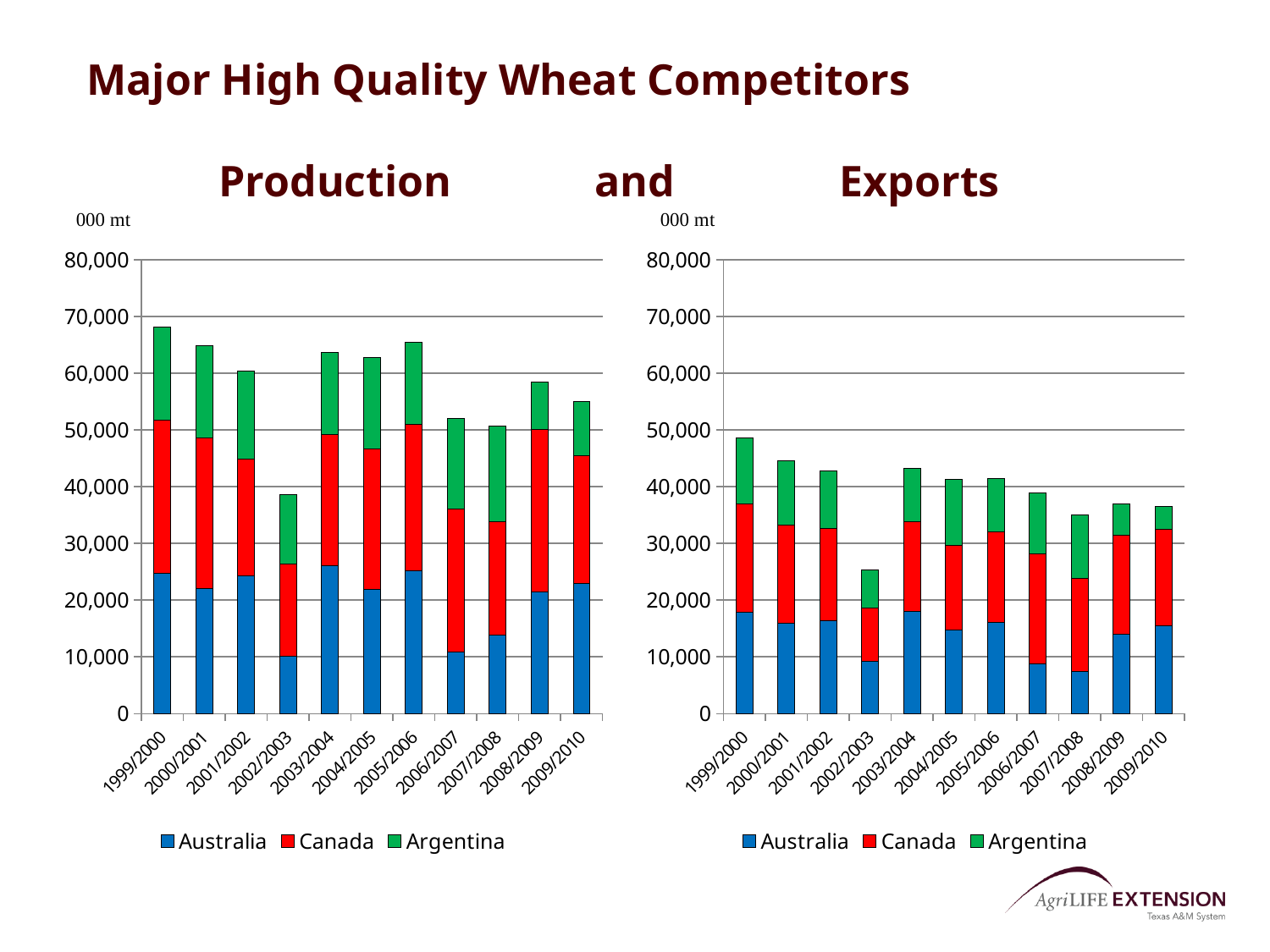
In the Exports chart, which year has the lowest total stacked bar? 2002/2003 How many series does the legend of the Exports chart list? 3 In the Production chart, which year has the larger total, 2002/2003 or 2003/2004? 2003/2004 What unit is shown above the y axis of the Exports chart? 000 mt In the Exports chart, do the total bars generally rise or fall from 1999/2000 to 2009/2010? fall In the Exports chart, is the total for 2007/2008 greater or less than 40,000? less In the Production chart, is the total for 2002/2003 greater or less than 40,000? less In the Production chart, is the total for 1999/2000 greater or less than 60,000? greater In the Production chart, which year has the lowest total stacked bar? 2002/2003 What type of chart is the Production chart? stacked bar chart How many marketing years are shown on the x axis of the Production chart? 11 In the Exports chart, which year has the highest total stacked bar? 1999/2000